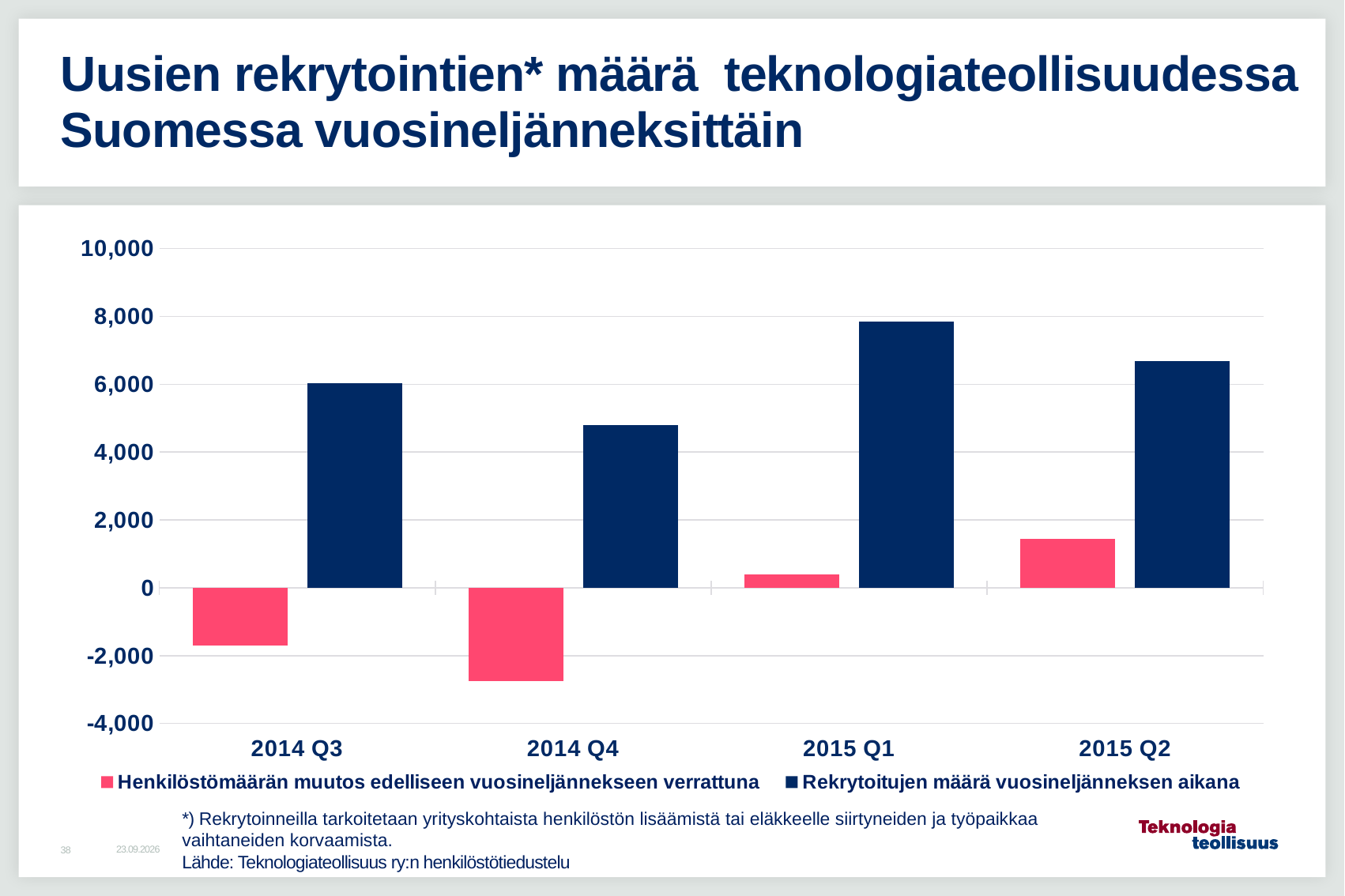
Is the value for Henkilöstömäärän muutos edelliseen vuosineljännekseen verrattuna in 2014 Q4 greater or less than -2,000? less Which quarter has the highest value for Rekrytoitujen määrä vuosineljänneksen aikana? 2015 Q1 Which quarter has the lowest value for Rekrytoitujen määrä vuosineljänneksen aikana? 2014 Q4 What kind of chart is shown on the slide? bar chart Is the value for Rekrytoitujen määrä vuosineljänneksen aikana in 2015 Q1 greater or less than 6,000? greater Which is larger, the Rekrytoitujen määrä vuosineljänneksen aikana value for 2014 Q3 or for 2014 Q4? 2014 Q3 Does the Henkilöstömäärän muutos edelliseen vuosineljännekseen verrattuna series rise or fall from 2014 Q4 to 2015 Q2? rise Which quarter has the highest value for Henkilöstömäärän muutos edelliseen vuosineljännekseen verrattuna? 2015 Q2 Which quarter has the lowest value for Henkilöstömäärän muutos edelliseen vuosineljännekseen verrattuna? 2014 Q4 How many quarters are shown on the x axis? 4 Which colour represents Rekrytoitujen määrä vuosineljänneksen aikana in the legend? dark blue How many series does the legend list? 2